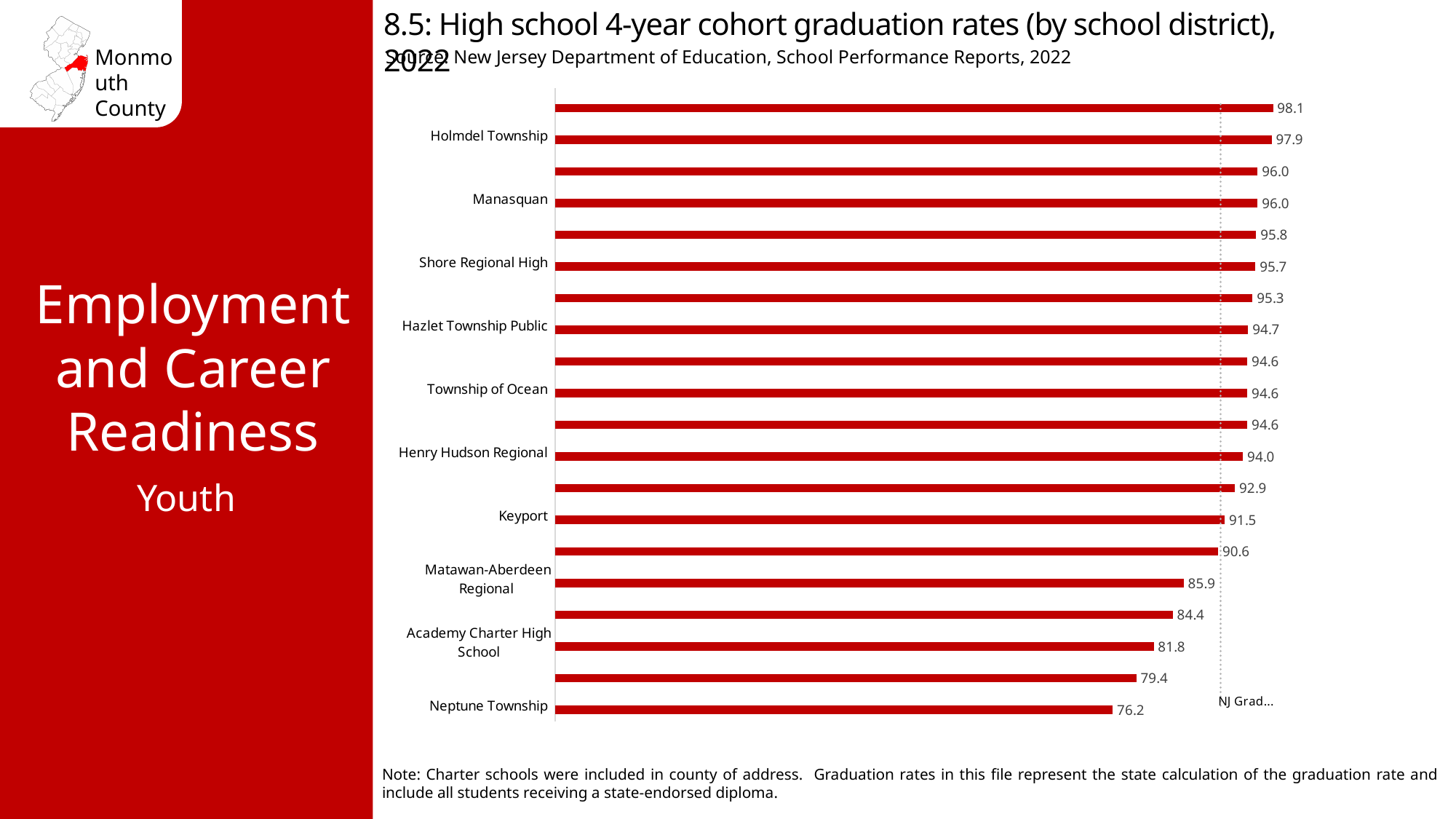
What kind of chart is shown on the slide? Bar chart What is the graduation rate shown for Academy Charter High School? 81.8 Which labeled school district has the lowest graduation rate on the chart? Neptune Township Which has a higher graduation rate, Keyport or Matawan-Aberdeen Regional? Keyport What is the graduation rate shown for Neptune Township? 76.2 What is the 4-year cohort graduation rate for Holmdel Township? 97.9 What is the graduation rate shown for Keyport? 91.5 What is the source of the data cited on the slide? New Jersey Department of Education, School Performance Reports, 2022 What is the highest graduation rate value shown on the chart? 98.1 What is the graduation rate shown for Matawan-Aberdeen Regional? 85.9 What is the difference between the graduation rates of Holmdel Township and Neptune Township? 21.7 How many bars are plotted on the chart? 20